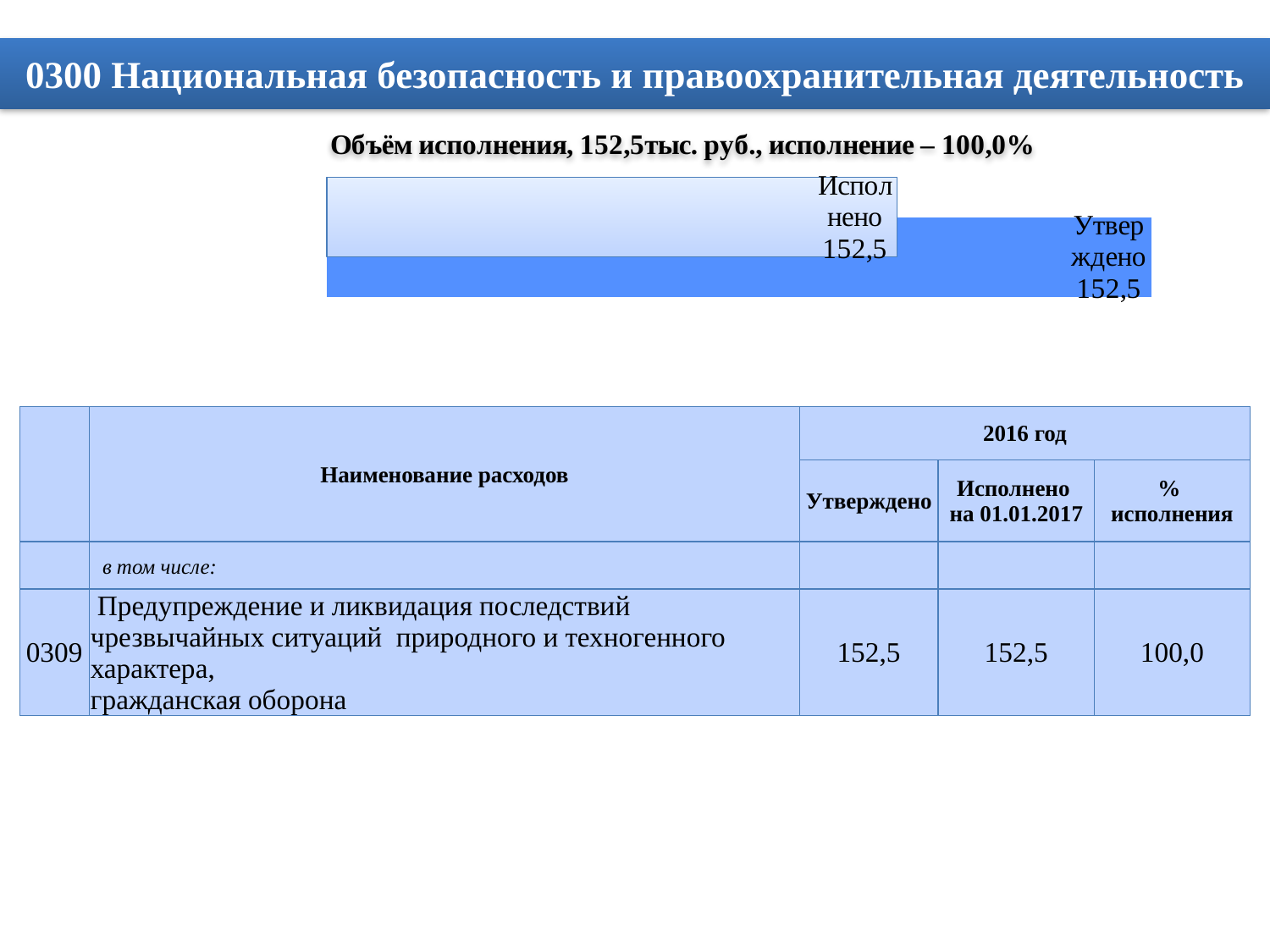
How many bars are plotted in the chart? 2 What is the value of the bar labelled "Исполнено"? 152,5 Are the bars in the chart oriented horizontally or vertically? horizontally What is the value of the bar labelled "Утверждено"? 152,5 What is the difference between the "Утверждено" and "Исполнено" values in the chart? 0,0 What kind of chart is shown on the slide? bar chart What are the labels of the two bars in the chart? Исполнено and Утверждено